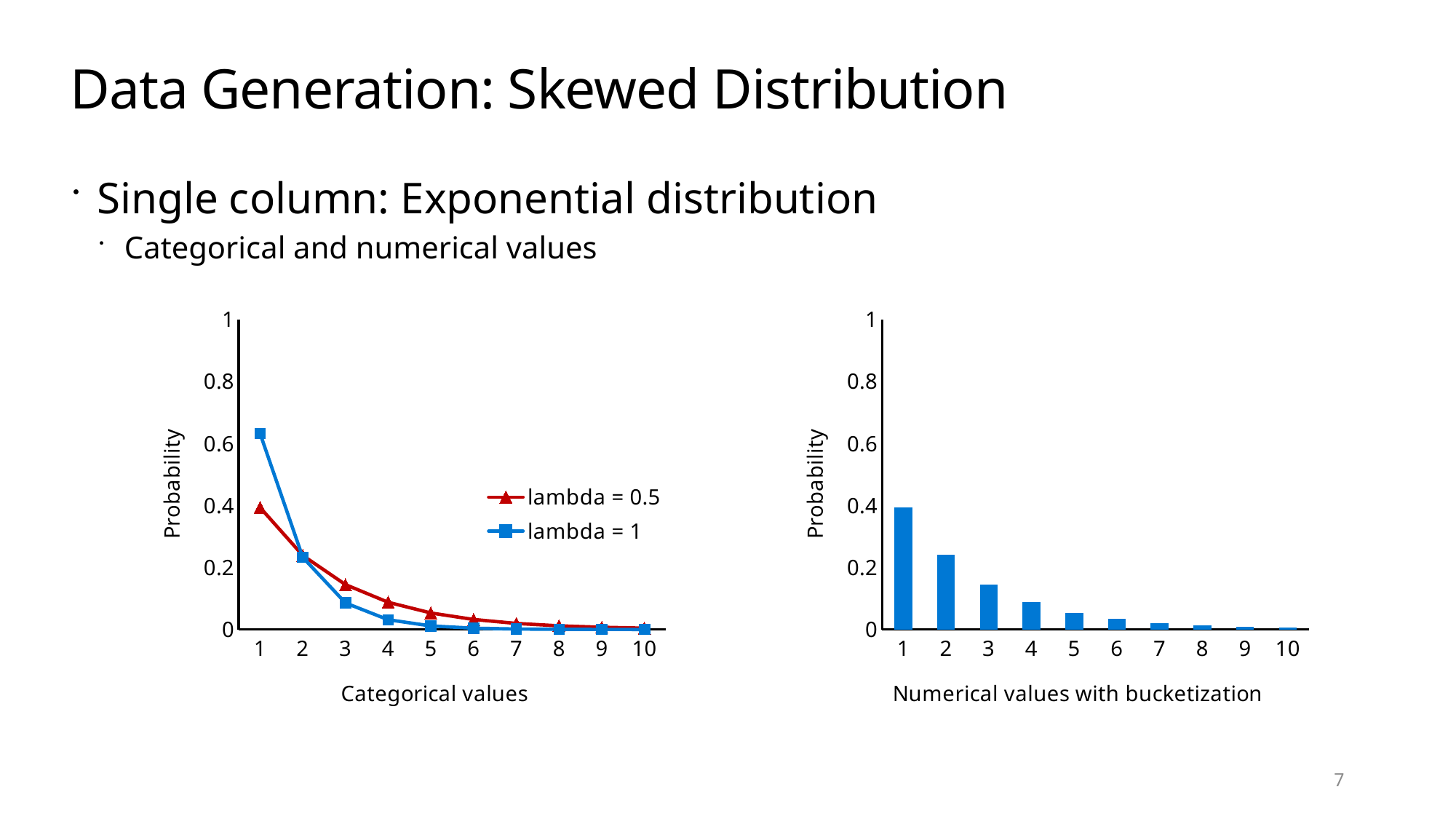
What kind of chart is the left chart, labelled "Categorical values"? line chart In the right chart (Numerical values with bucketization), which category has the highest bar? 1 In the left chart (Categorical values), which series has the larger value at x = 3, lambda = 0.5 or lambda = 1? lambda = 0.5 In the left chart (Categorical values), how many series does the legend list? 2 In the right chart (Numerical values with bucketization), how many bars are plotted? 10 In the left chart (Categorical values), is the value of the lambda = 1 series at x = 1 greater or less than 0.6? greater In the left chart (Categorical values), do the values of the lambda = 0.5 series rise or fall as x increases from 1 to 10? fall In the left chart (Categorical values), what are the two legend entries? lambda = 0.5 and lambda = 1 In the left chart (Categorical values), which series has the larger value at x = 1, lambda = 0.5 or lambda = 1? lambda = 1 What kind of chart is the right chart, labelled "Numerical values with bucketization"? bar chart In the right chart (Numerical values with bucketization), is the value for category 2 greater or less than 0.2? greater